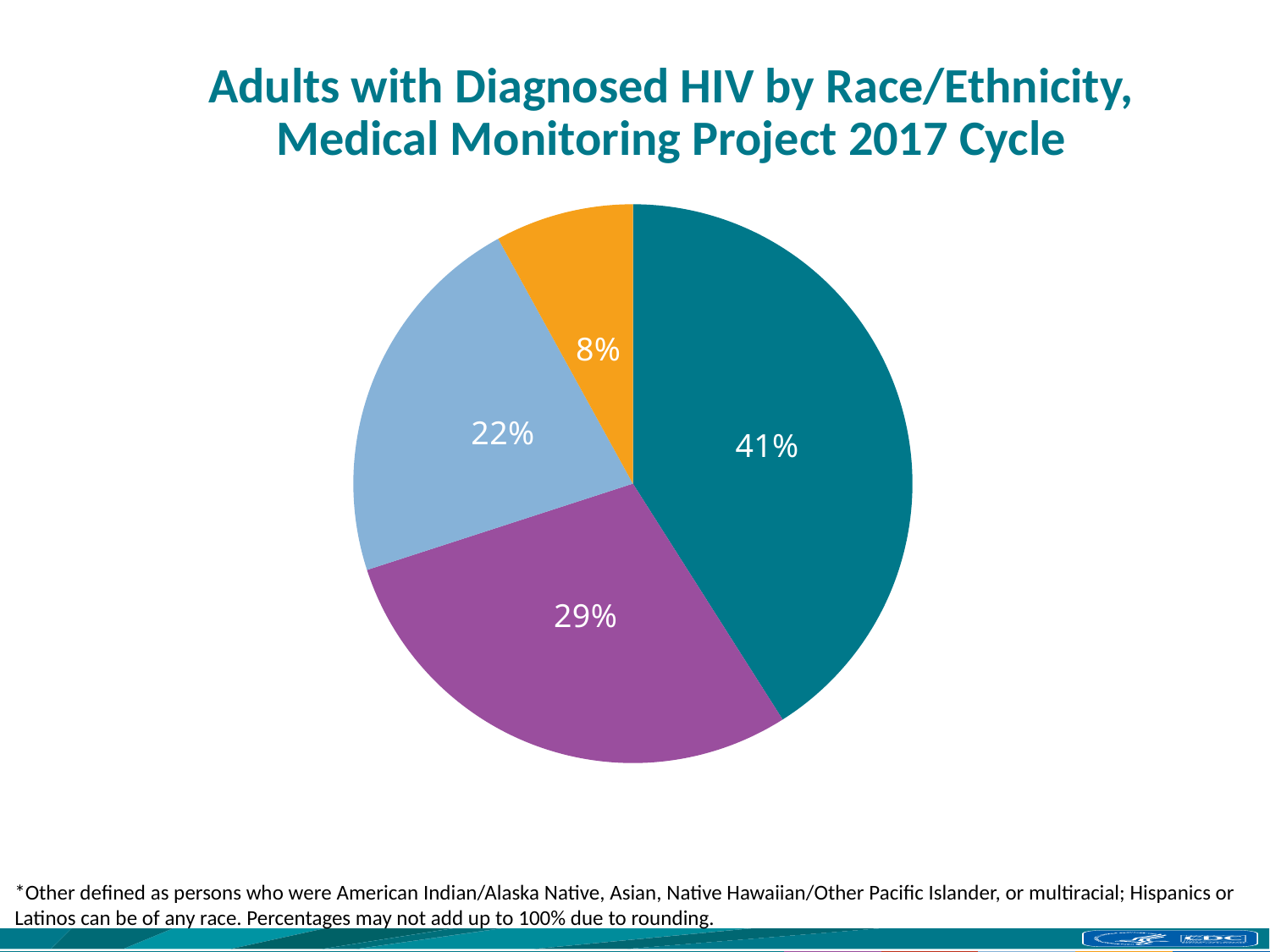
What percentage is shown on the orange slice of the pie chart? 8% How many slices does the pie chart have? 4 What percentage is shown on the teal (dark green) slice of the pie chart? 41% Which colour slice represents the largest share of the pie chart? teal Which is larger, the purple slice or the light blue slice? purple slice What is the title of the chart on the slide? Adults with Diagnosed HIV by Race/Ethnicity, Medical Monitoring Project 2017 Cycle What percentage is shown on the purple slice of the pie chart? 29% What is the difference in percentage points between the teal slice and the purple slice? 12 What percentage is shown on the light blue slice of the pie chart? 22% What kind of chart is shown on the slide? pie chart Which colour slice represents the smallest share of the pie chart? orange What is the difference in percentage points between the light blue slice and the orange slice? 14